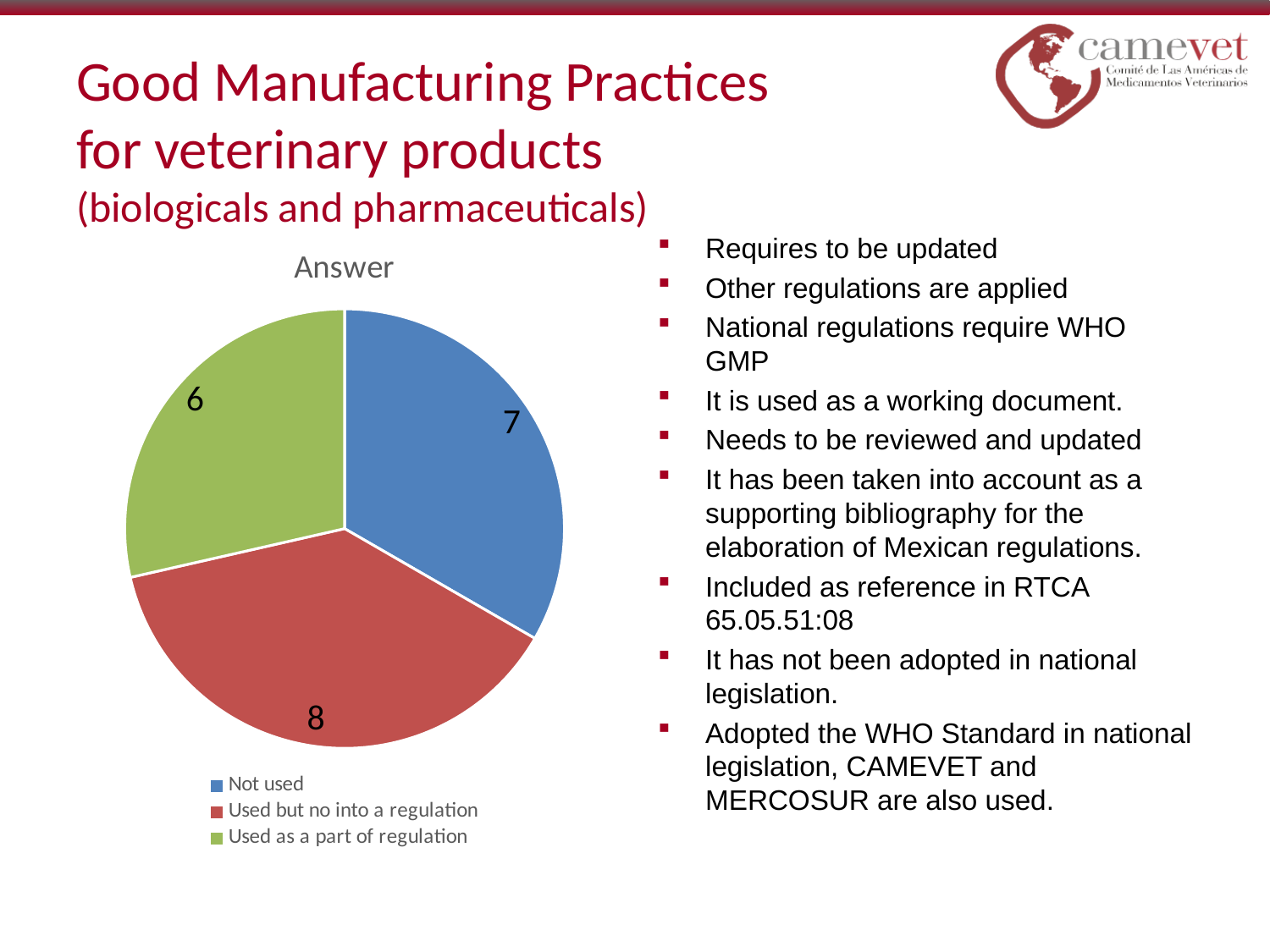
What is the value for "Used as a part of regulation"? 6 Which category has the largest slice of the pie? Used but no into a regulation How many slices does the pie chart have? 3 What is the total of all the slices in the pie chart? 21 Which colour represents "Not used" in the pie chart? Blue What is the value for "Not used"? 7 Which is larger, the value for "Not used" or the value for "Used as a part of regulation"? Not used What is the title of the chart? Answer What is the value for "Used but no into a regulation"? 8 What kind of chart is shown on the slide? Pie chart What is the difference between the values for "Used but no into a regulation" and "Used as a part of regulation"? 2 Which category has the smallest slice of the pie? Used as a part of regulation